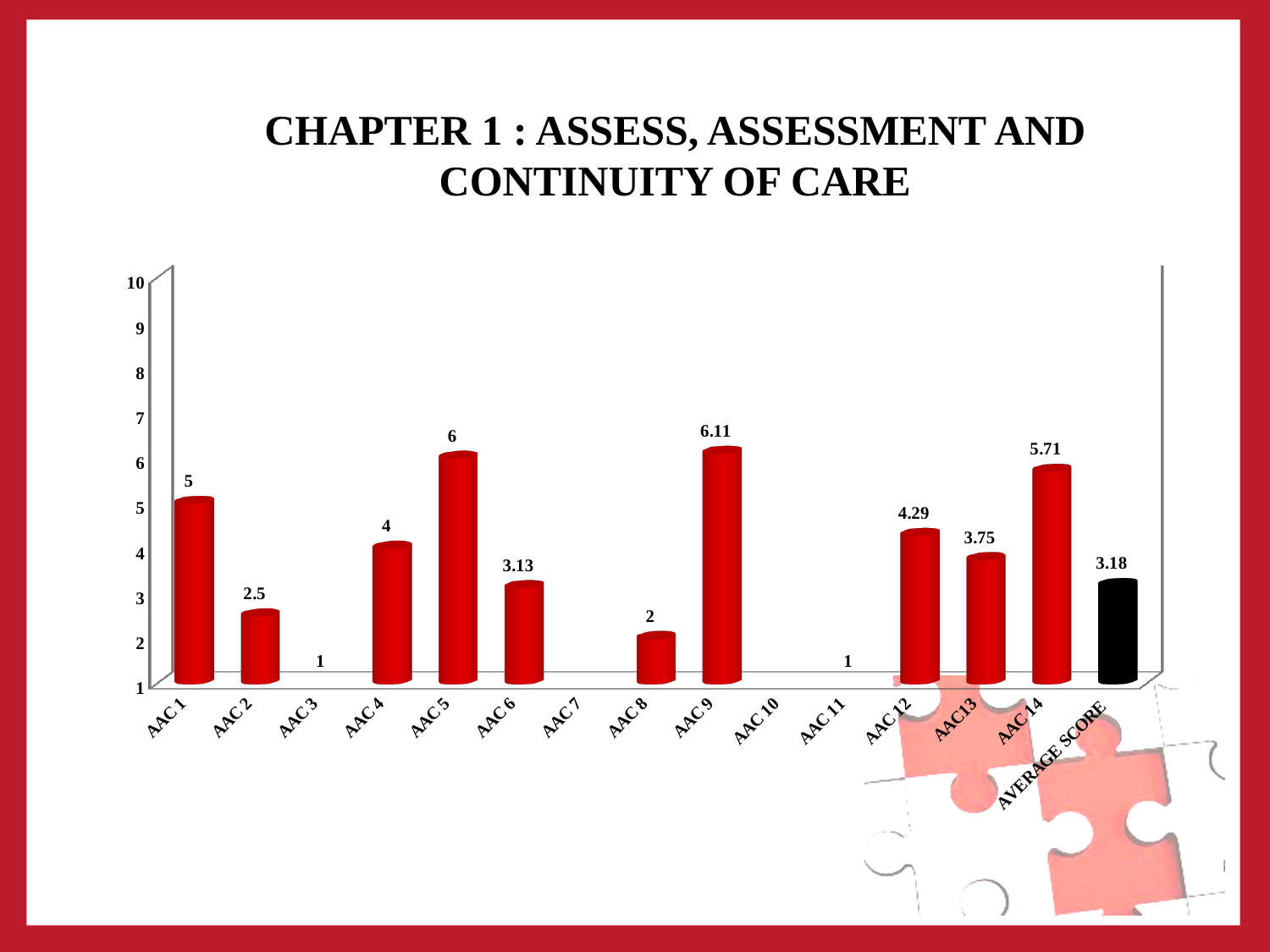
What is the AVERAGE SCORE shown on the chart? 3.18 How many categories are shown on the x axis? 15 What is the value for AAC 8? 2 What is the difference between the value for AAC 14 and the AVERAGE SCORE? 2.53 Is the value for AAC 4 greater or less than 3? greater What is the value for AAC 1? 5 Which category has the highest value? AAC 9 What is the value for AAC 9? 6.11 What is the value for AAC 6? 3.13 What is the difference between the values for AAC 5 and AAC 2? 3.5 Which is larger, the value for AAC 12 or the value for AAC13? AAC 12 What kind of chart is shown on the slide? bar chart